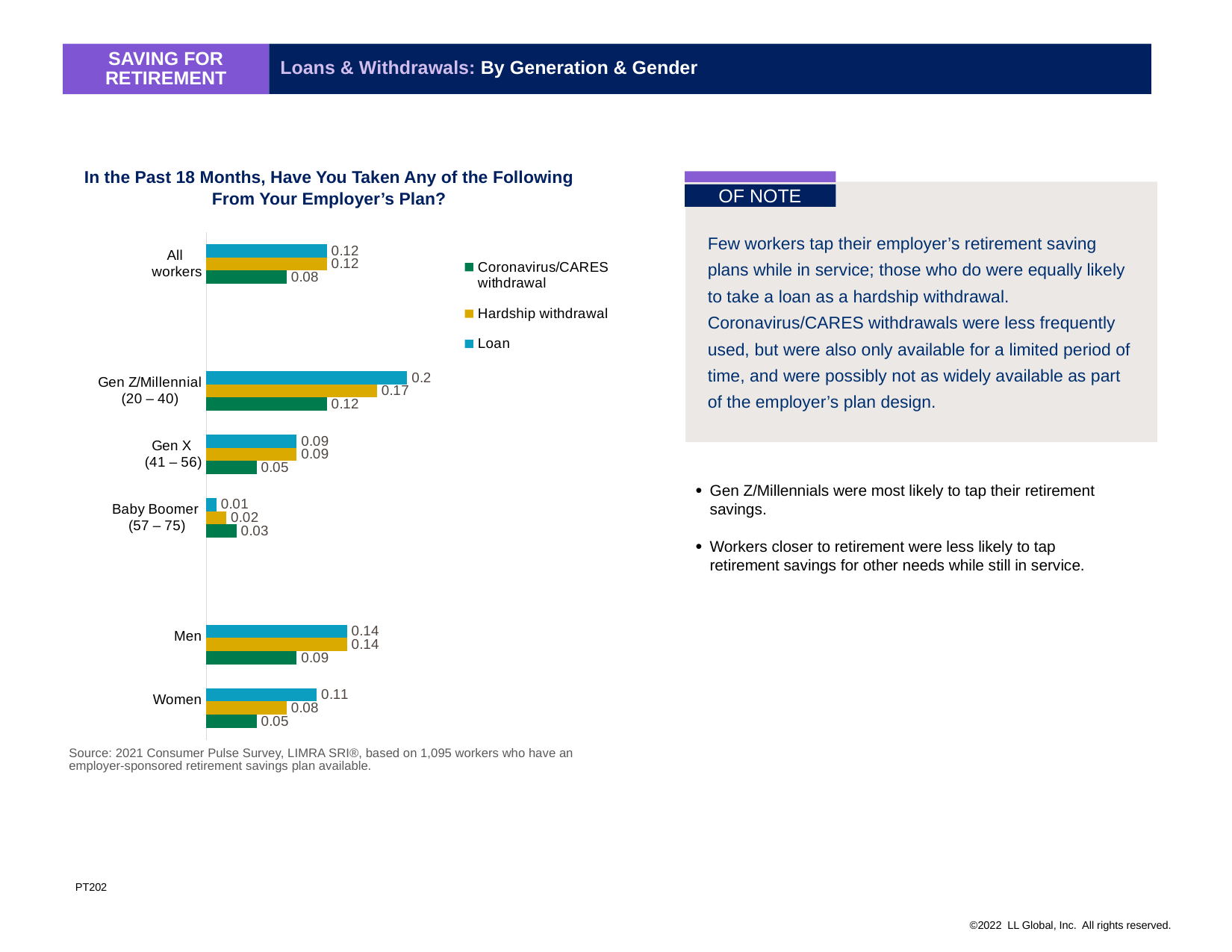
What is the Coronavirus/CARES withdrawal value for All workers? 0.08 Which category has the highest Loan value? Gen Z/Millennial (20 – 40) Which is larger for Baby Boomer (57 – 75): the Loan value or the Coronavirus/CARES withdrawal value? Coronavirus/CARES withdrawal How many categories are shown on the chart? 6 What kind of chart is shown on the slide? Bar chart What is the Hardship withdrawal value for Women? 0.08 What is the Coronavirus/CARES withdrawal value for Baby Boomer (57 – 75)? 0.03 What is the Loan value for Gen Z/Millennial (20 – 40)? 0.2 What is the difference between the Loan values for Men and Women? 0.03 How many series does the legend list? 3 What is the difference between the Hardship withdrawal values for Gen Z/Millennial (20 – 40) and Gen X (41 – 56)? 0.08 Which category has the lowest Hardship withdrawal value? Baby Boomer (57 – 75)